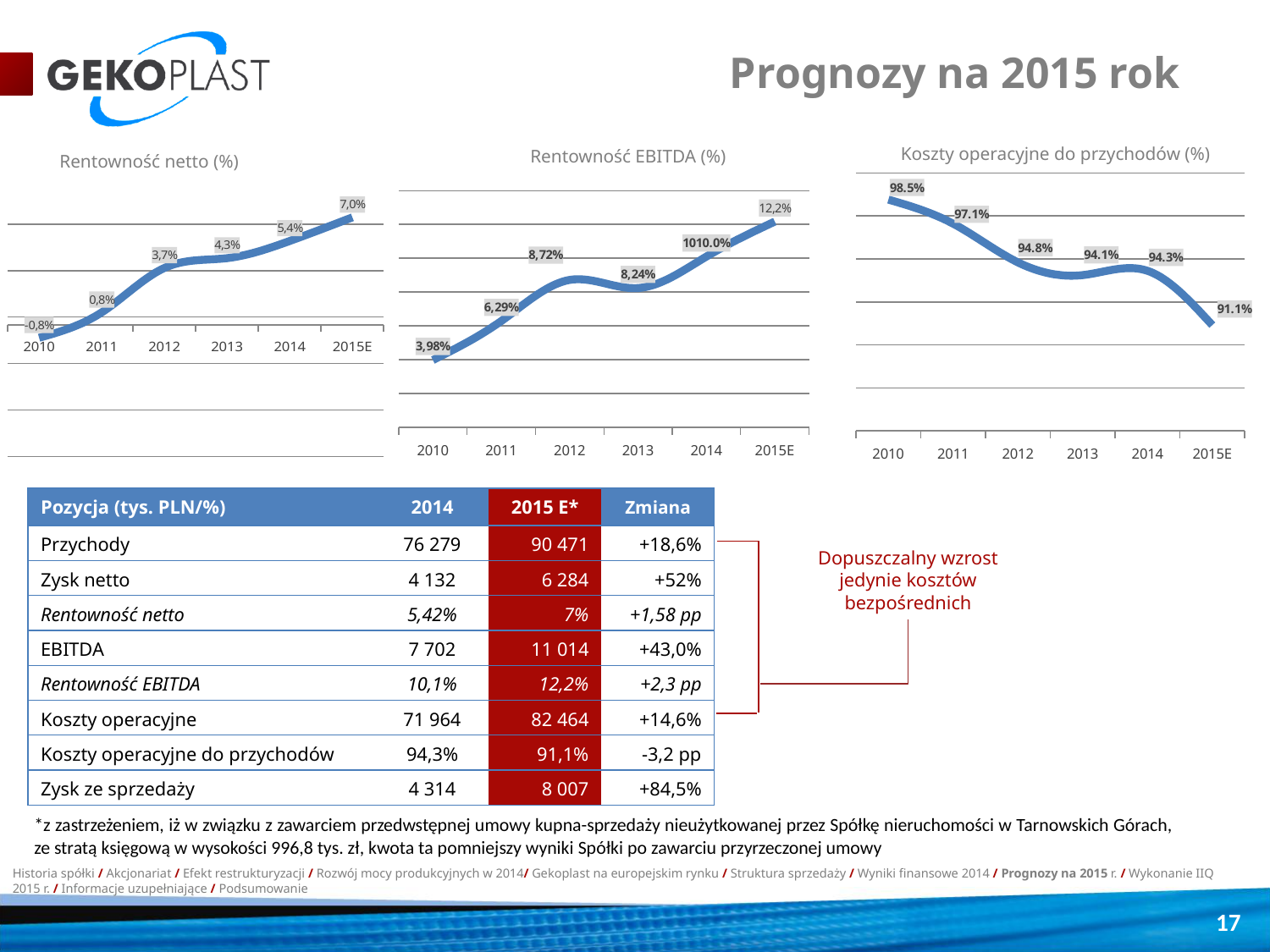
In the 'Koszty operacyjne do przychodów (%)' chart, what is the difference between the 2010 and 2011 values? 1.4 pp In the 'Rentowność netto (%)' chart, which year has the lowest value? 2010 In the 'Rentowność EBITDA (%)' chart, which is larger, the value for 2012 or the value for 2013? 2012 In the 'Koszty operacyjne do przychodów (%)' chart, do the values generally rise or fall from 2010 to 2015E? fall In the 'Rentowność EBITDA (%)' chart, what is the value for 2010? 3,98% In the 'Rentowność netto (%)' chart, what is the difference between the 2014 and 2013 values? 1,1 pp In the 'Rentowność EBITDA (%)' chart, which year has the highest value? 2015E In the 'Rentowność netto (%)' chart, what is the value for 2010? -0,8% In the 'Koszty operacyjne do przychodów (%)' chart, what is the value for 2015E? 91.1% In the 'Rentowność EBITDA (%)' chart, what is the value for 2012? 8,72% In the 'Rentowność netto (%)' chart, what is the value for 2015E? 7,0% How many data points are plotted in the 'Koszty operacyjne do przychodów (%)' chart? 6